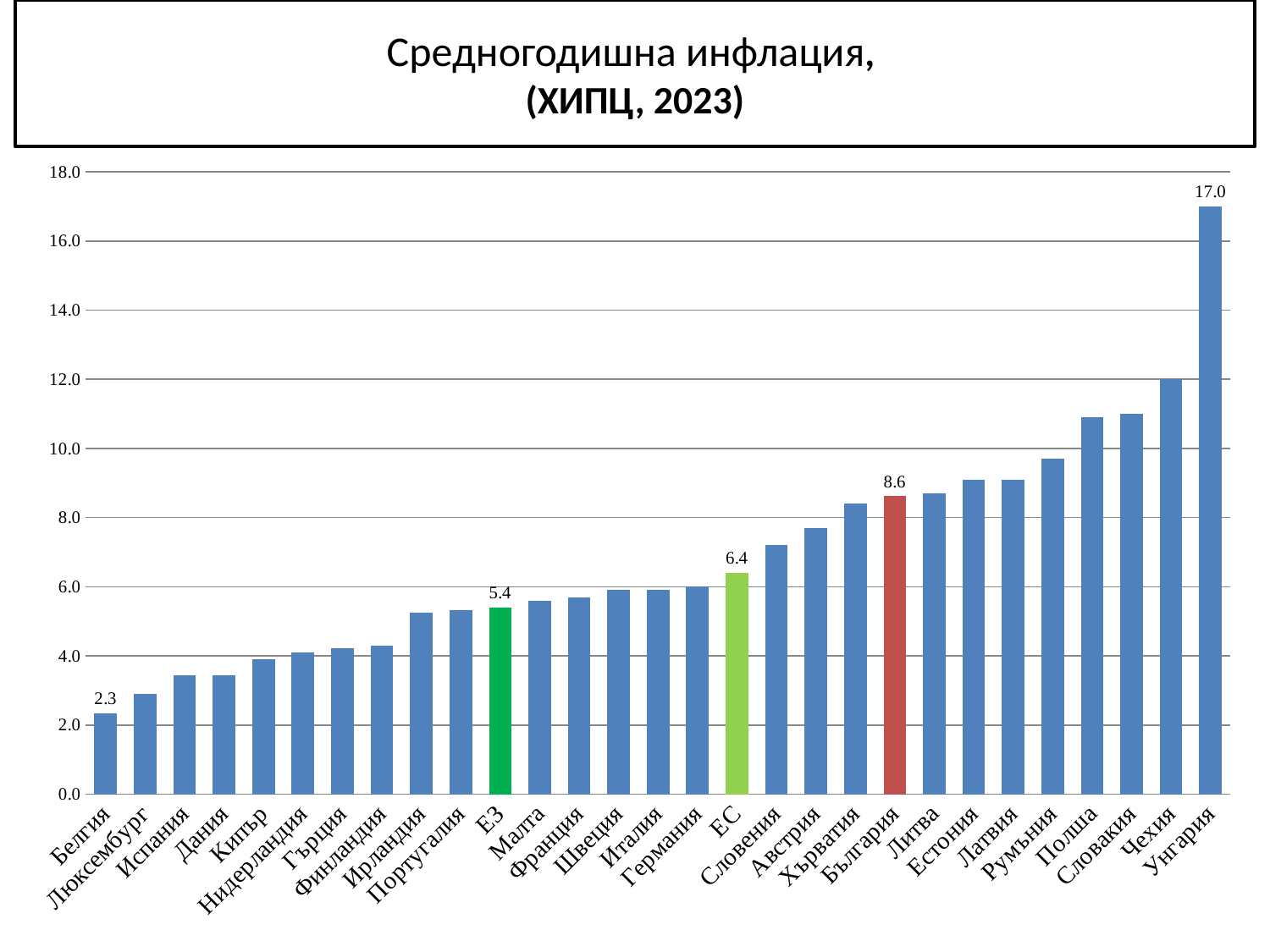
What type of chart is shown on the slide? bar chart What is the value for ЕС? 6.4 What is the value for Унгария? 17.0 What is the value for ЕЗ? 5.4 Which is larger, the value for ЕС or the value for ЕЗ? ЕС What colour is the bar for България? red Is the value for Чехия greater or less than 10.0? greater How many categories are shown on the x axis? 29 Which country has the highest value? Унгария What is the difference between the values for България and ЕС? 2.2 What is the value for България? 8.6 Which country has the lowest value? Белгия